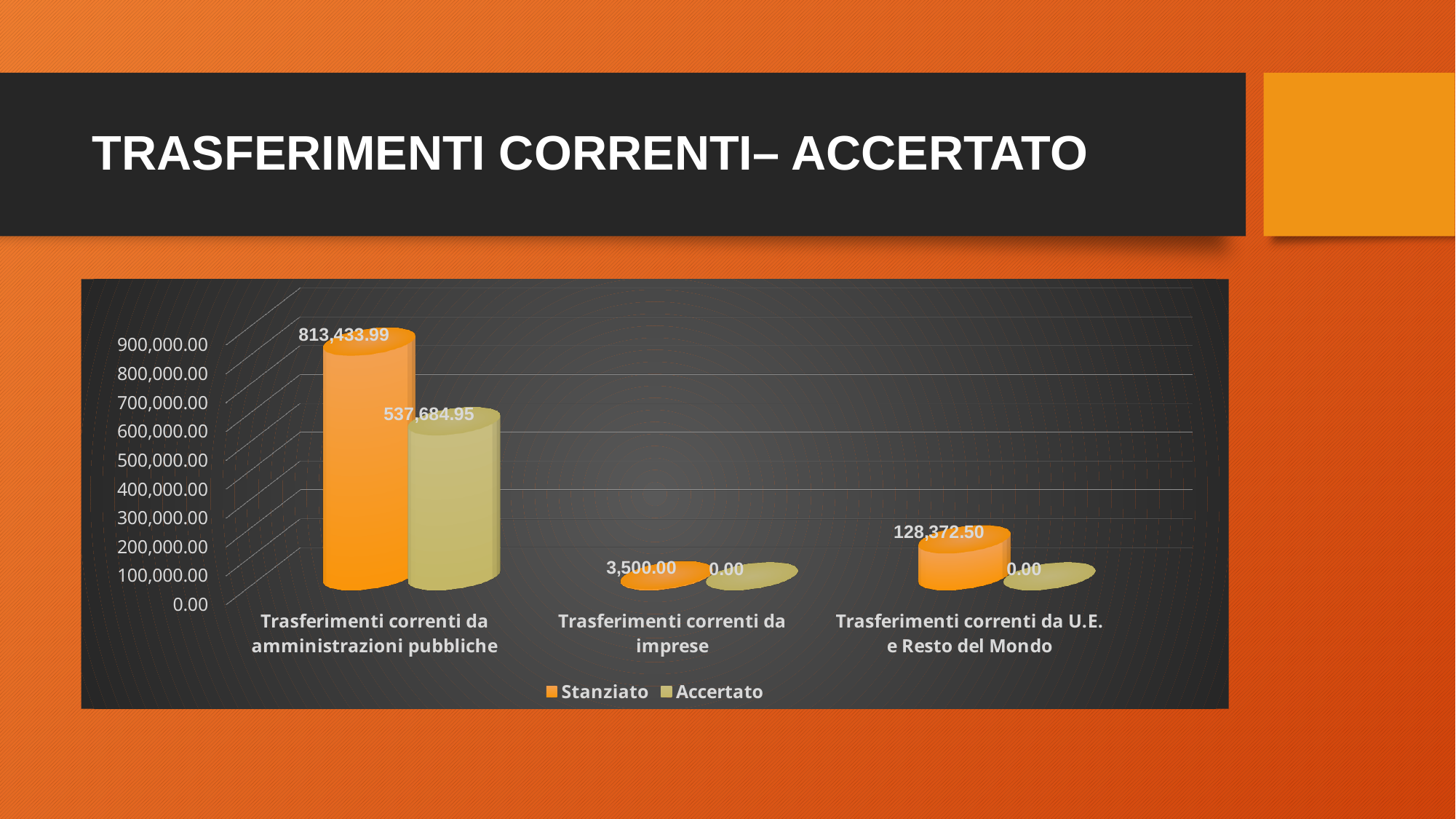
How many series does the legend list? 2 What is the difference between the Stanziato and Accertato values for Trasferimenti correnti da amministrazioni pubbliche? 275,749.04 What is the Stanziato value for Trasferimenti correnti da imprese? 3,500.00 What is the Stanziato value for Trasferimenti correnti da amministrazioni pubbliche? 813,433.99 How many categories are shown on the x axis? 3 What is the Stanziato value for Trasferimenti correnti da U.E. e Resto del Mondo? 128,372.50 What kind of chart is shown on the slide? Bar chart Which category has the highest Stanziato value? Trasferimenti correnti da amministrazioni pubbliche Which category has the lowest Stanziato value? Trasferimenti correnti da imprese Which is larger: the Stanziato value for Trasferimenti correnti da U.E. e Resto del Mondo or the Stanziato value for Trasferimenti correnti da imprese? Trasferimenti correnti da U.E. e Resto del Mondo What is the Accertato value for Trasferimenti correnti da amministrazioni pubbliche? 537,684.95 What is the Accertato value for Trasferimenti correnti da U.E. e Resto del Mondo? 0.00